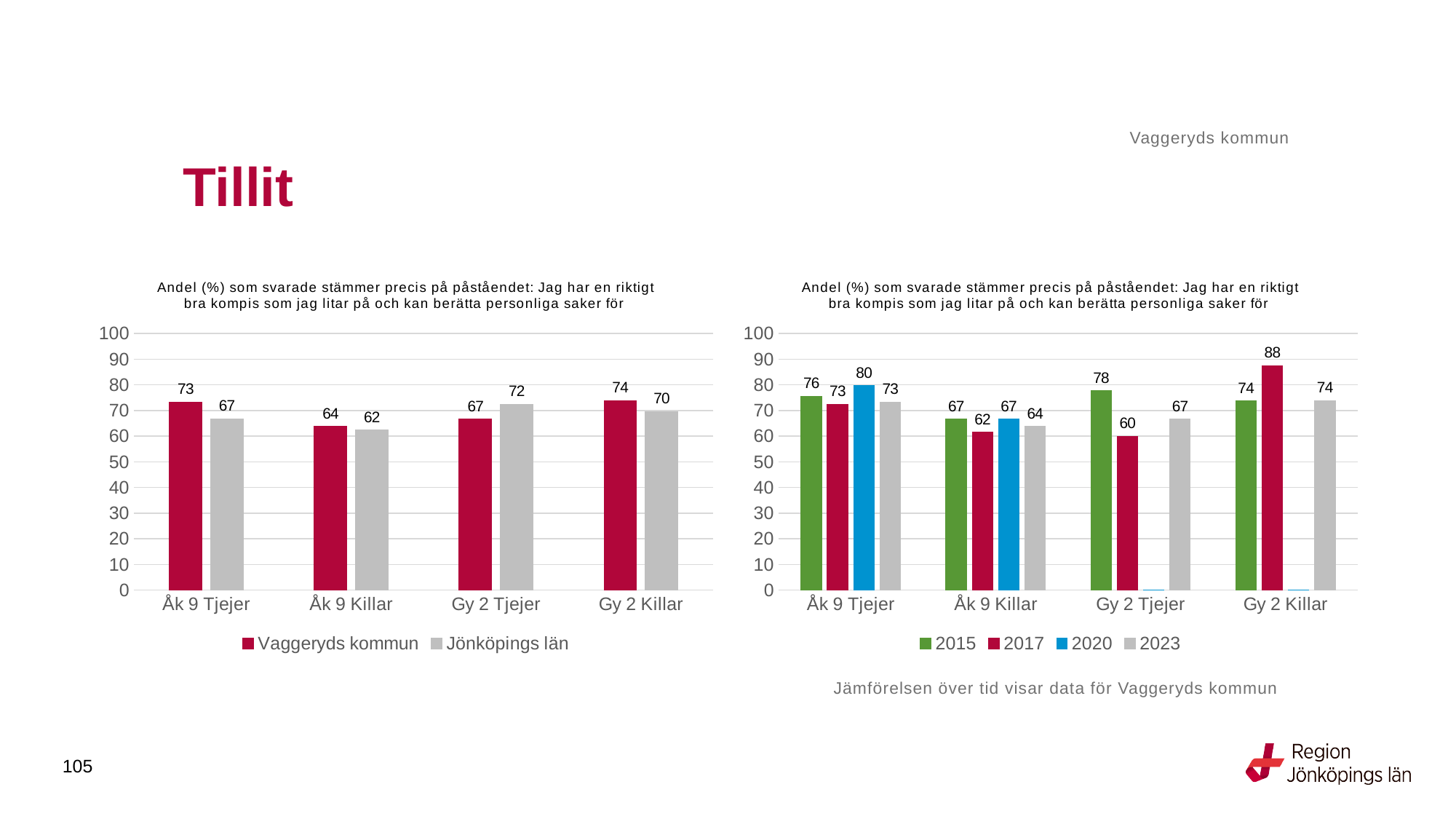
In the right chart, what is the value for 2017 for Gy 2 Killar? 88 In the left chart, what is the value for Jönköpings län for Gy 2 Tjejer? 72 In the left chart, which is larger for Gy 2 Tjejer: Vaggeryds kommun or Jönköpings län? Jönköpings län In the left chart, how many categories are shown on the x axis? 4 In the left chart, what is the value for Vaggeryds kommun for Åk 9 Tjejer? 73 In the left chart, which category has the lowest value for Jönköpings län? Åk 9 Killar How many series does the legend of the right chart list? 4 In the left chart, what is the difference between Vaggeryds kommun and Jönköpings län for Åk 9 Tjejer? 6 In the right chart, which year has the highest value for Gy 2 Tjejer? 2015 In the right chart, what is the value for 2020 for Åk 9 Tjejer? 80 What type of chart is the right chart? Bar chart In the right chart, what is the difference between the 2015 and 2017 values for Gy 2 Tjejer? 18